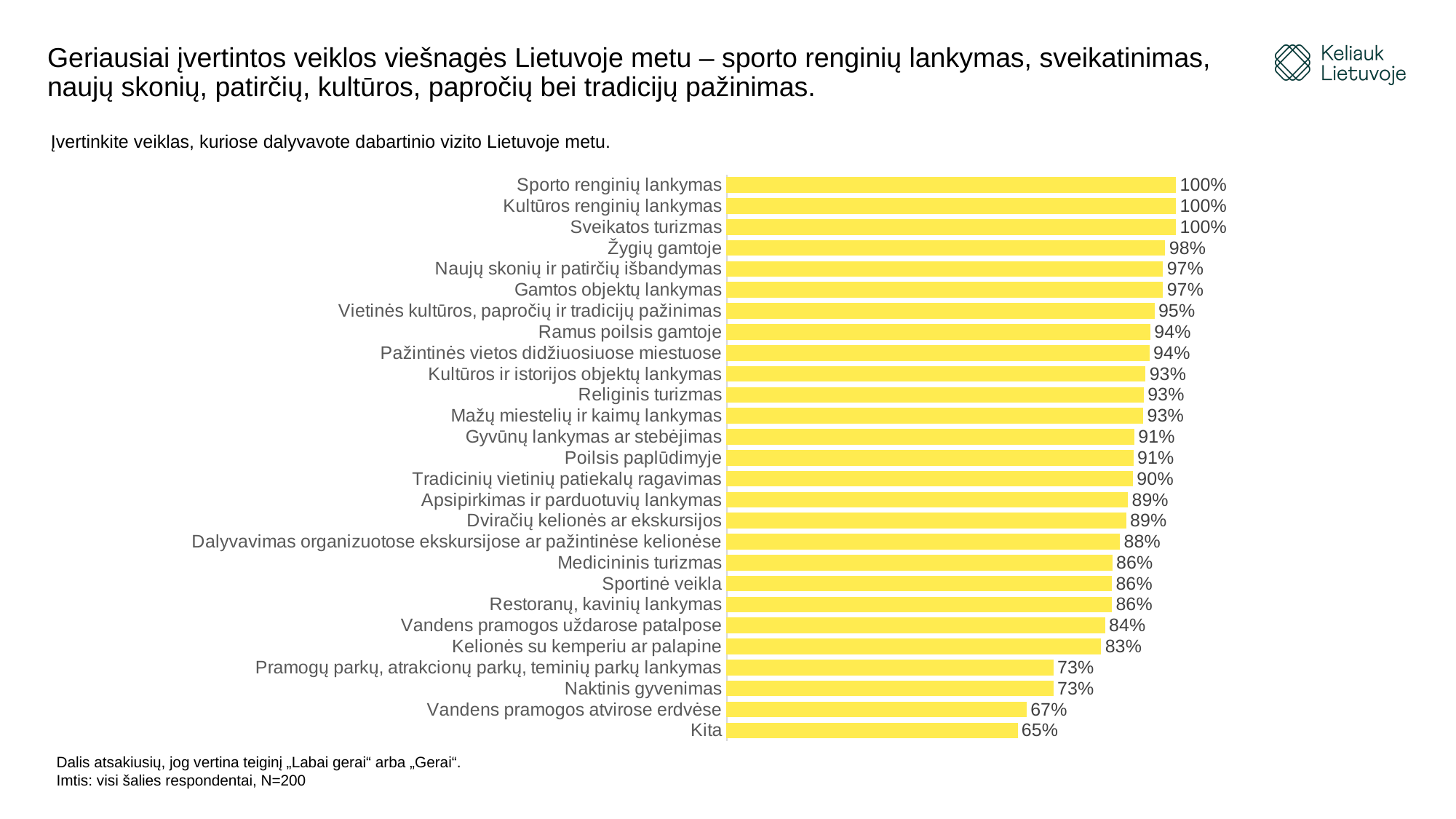
What is the value for Medicininis turizmas? 86% Which is larger, the value for Religinis turizmas or the value for Sportinė veikla? Religinis turizmas How many categories are shown on the chart? 27 What is the value for Naktinis gyvenimas? 73% What is the value for Žygių gamtoje? 98% What is the difference between the values for Kelionės su kemperiu ar palapine and Naktinis gyvenimas? 10% What kind of chart is shown on the slide? Bar chart What is the highest value shown on the chart? 100% Which category has the lowest value? Kita What is the value for Vandens pramogos atvirose erdvėse? 67% What colour are the bars on the chart? Yellow What is the difference between the values for Sveikatos turizmas and Kita? 35%